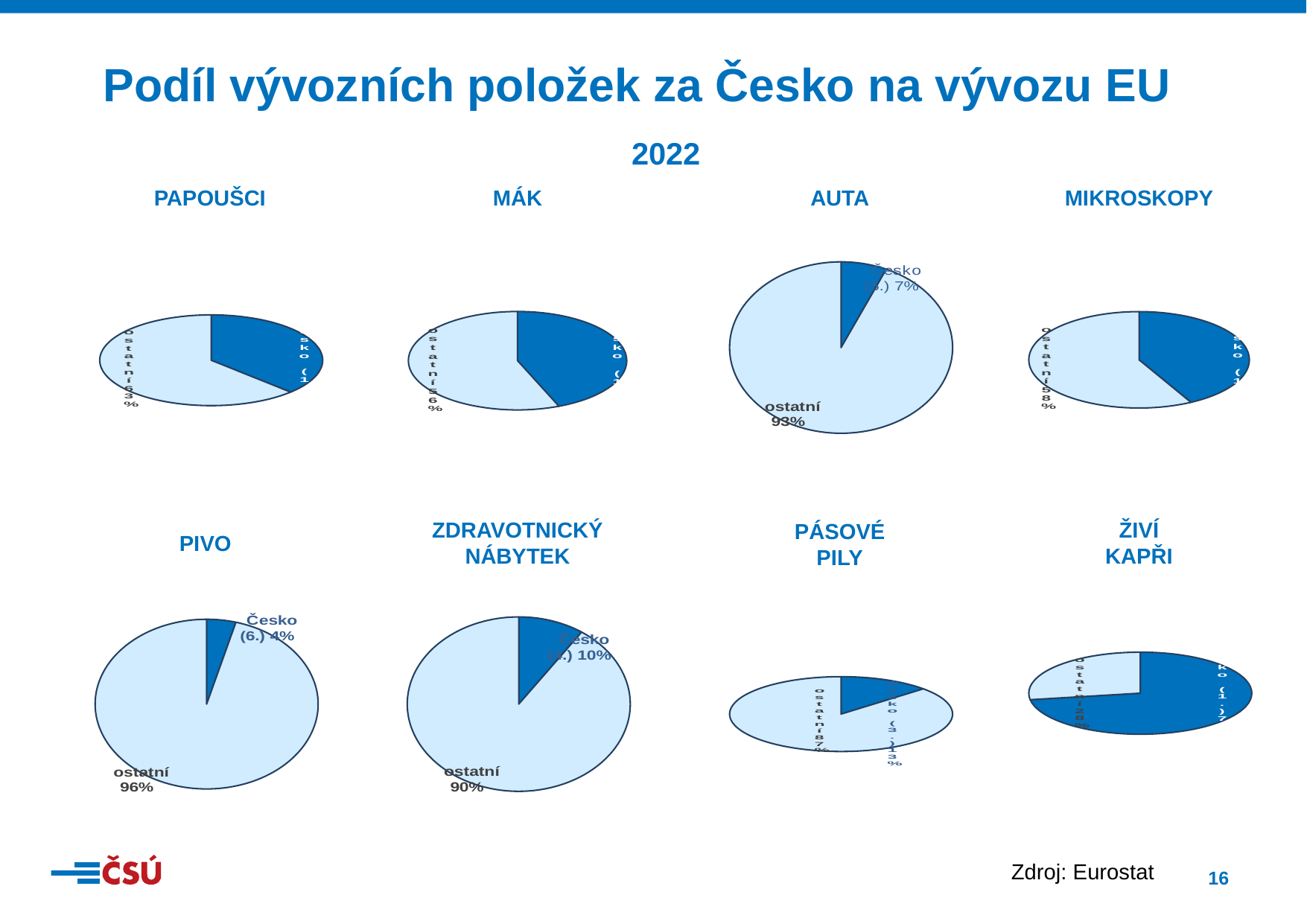
What kind of charts are shown on the slide? pie charts In the AUTA pie chart, what share does ostatní have? 93% What is the difference between the ostatní and Česko shares in the AUTA pie chart? 86% In the ZDRAVOTNICKÝ NÁBYTEK pie chart, what share does Česko have? 10% In the ZDRAVOTNICKÝ NÁBYTEK pie chart, what is the value for ostatní? 90% In the PIVO pie chart, what share does Česko have? 4% In the PIVO pie chart, what is the value for ostatní? 96% How many pie charts are on the slide? 8 Which is larger in the PIVO pie chart, the Česko slice or the ostatní slice? ostatní Which year do the pie charts on the slide refer to? 2022